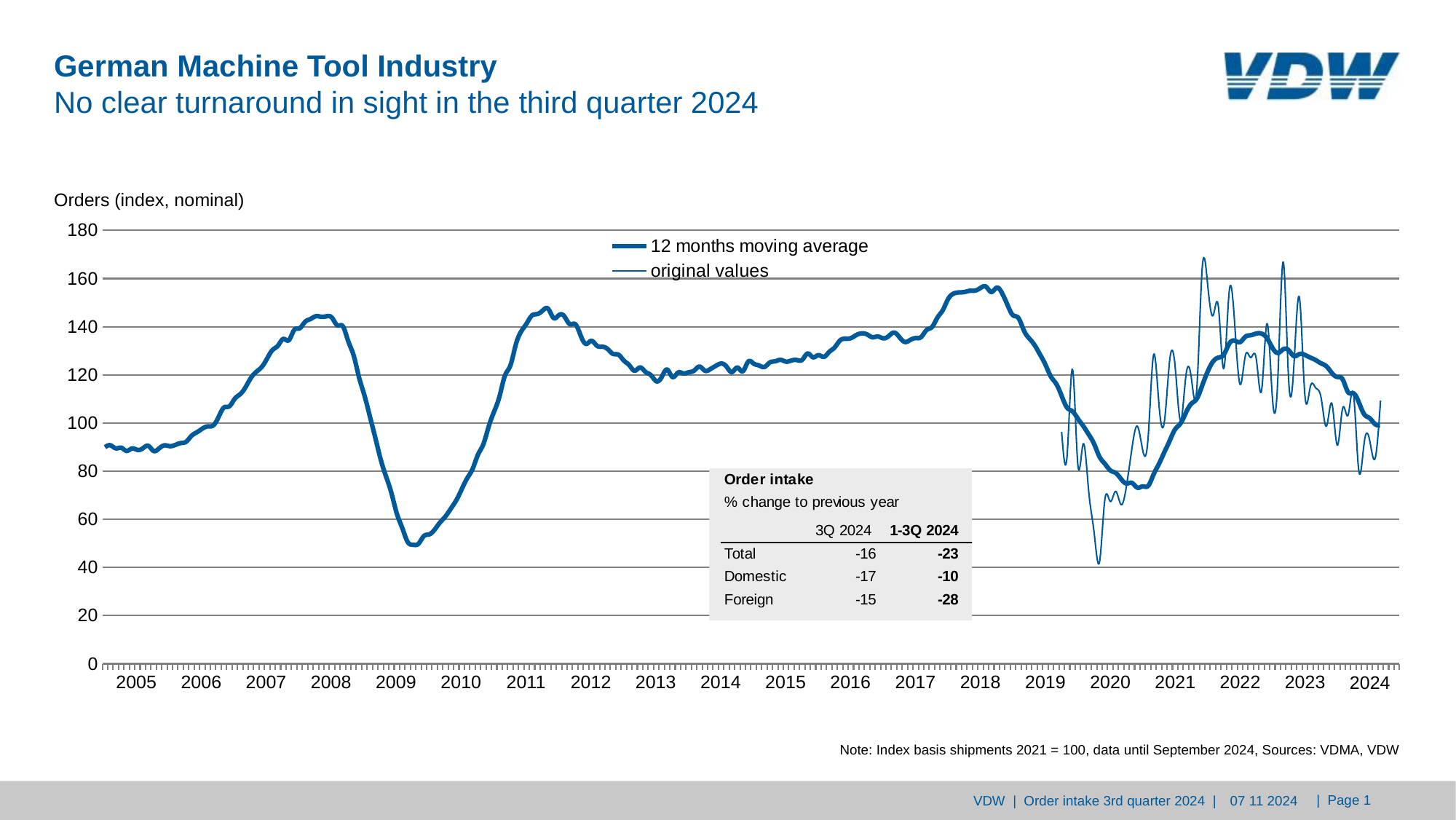
How many series does the chart legend list? 2 What are the two series named in the chart legend? 12 months moving average; original values How many year labels are shown along the x axis of the chart? 20 Does the 12 months moving average rise or fall between 2022 and 2024? fall In which year does the 12 months moving average reach its highest point? 2018 What is the label of the vertical axis of the chart? Orders (index, nominal) Which peak of the 12 months moving average is higher, the one in 2008 or the one in 2018? 2018 Is the lowest value of the 12 months moving average in 2009 greater or less than 60? less Is the value of the 12 months moving average at the end of 2024 greater or less than 120? less In which year does the 12 months moving average reach its lowest point? 2009 What kind of chart is shown on the slide? line chart Is the peak of the 12 months moving average in 2018 greater or less than 140? greater